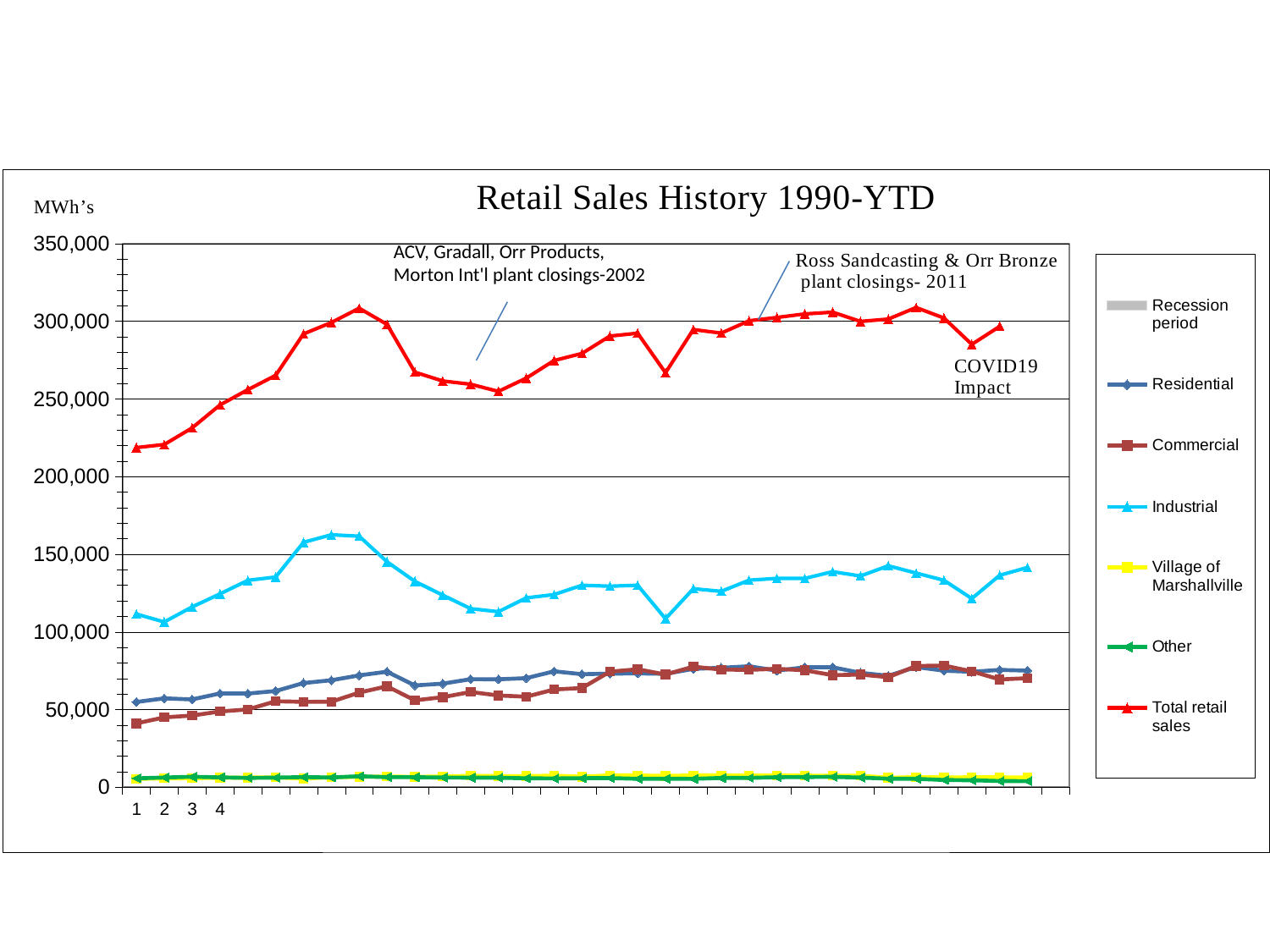
What kind of chart is shown on the slide? line chart What is the title of the chart? Retail Sales History 1990-YTD At point 1, which is larger: Industrial or Residential? Industrial Which series has the highest values across the chart? Total retail sales Is the value for Industrial at point 1 greater or less than 100,000? greater Do the Total retail sales values rise or fall from point 1 to point 4? rise Is the value for Commercial at point 1 greater or less than 50,000? less Is the value for Industrial at point 4 greater or less than 100,000? greater How many series does the legend list? 7 What unit is shown at the top of the y axis? MWh's